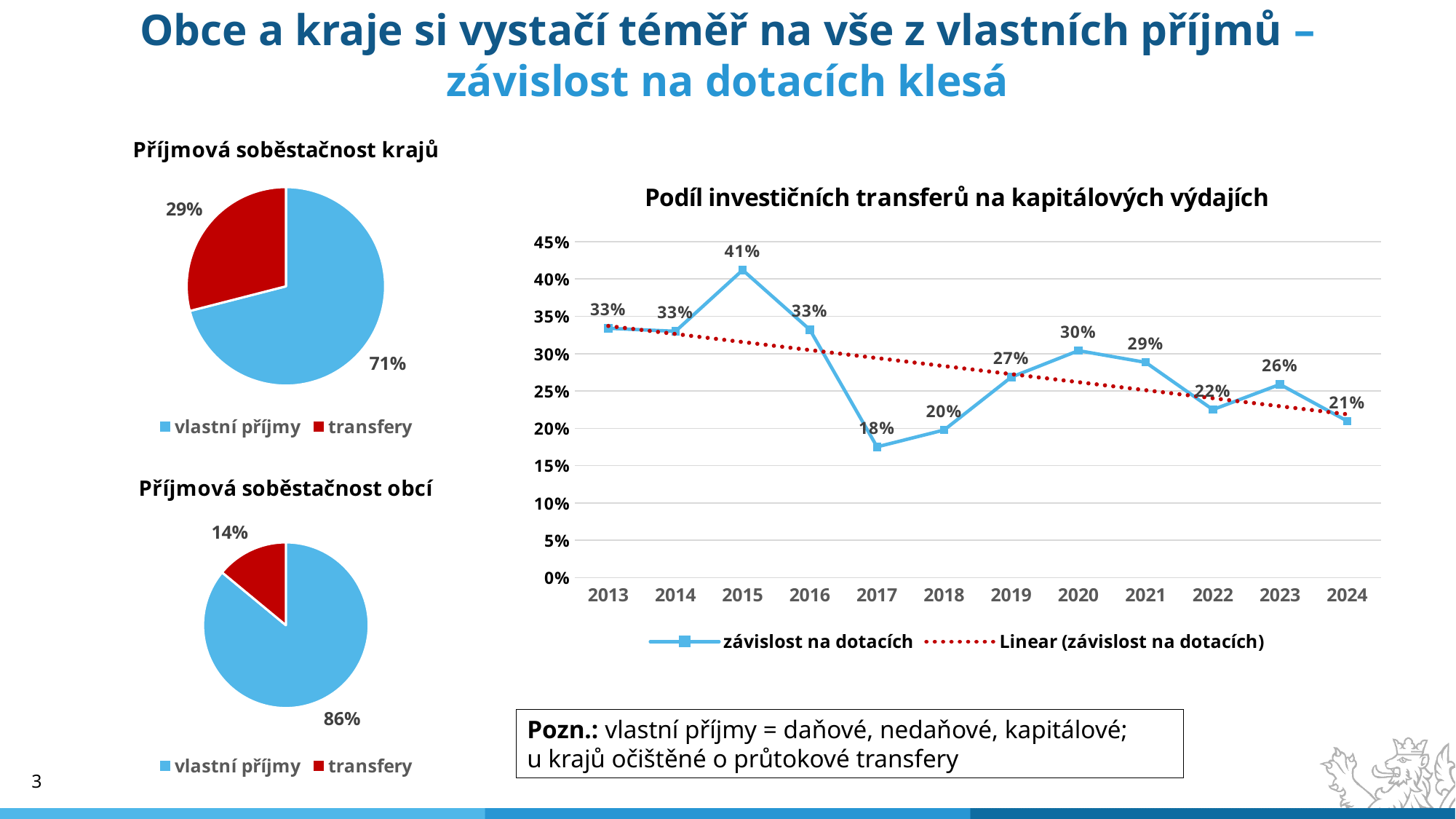
In the chart 'Příjmová soběstačnost krajů', what share does 'vlastní příjmy' have? 71% In the chart 'Příjmová soběstačnost krajů', what share does 'transfery' have? 29% What kind of chart is 'Příjmová soběstačnost obcí'? Pie chart In the chart 'Příjmová soběstačnost obcí', what share does 'transfery' have? 14% In the chart 'Podíl investičních transferů na kapitálových výdajích', how many entries does the legend list? 2 In the chart 'Podíl investičních transferů na kapitálových výdajích', which year has the highest value? 2015 In the chart 'Podíl investičních transferů na kapitálových výdajích', how many years are shown on the x axis? 12 In the chart 'Podíl investičních transferů na kapitálových výdajích', which year has the lowest value? 2017 In the chart 'Podíl investičních transferů na kapitálových výdajích', what is the value for 2015? 41% In the chart 'Podíl investičních transferů na kapitálových výdajích', what is the value for 2024? 21% In the chart 'Podíl investičních transferů na kapitálových výdajích', what is the difference between the values for 2015 and 2017? 23 percentage points